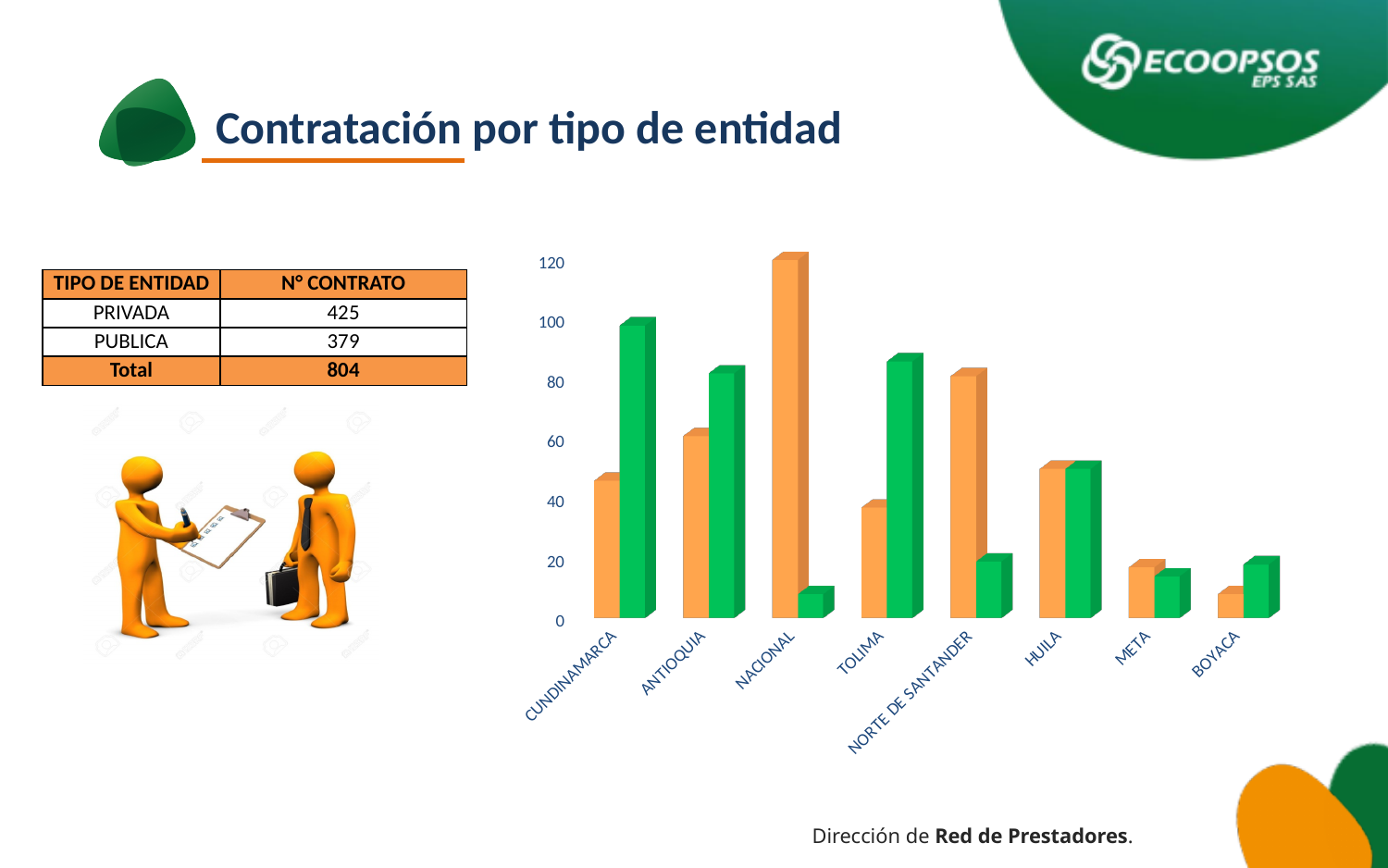
Which category has the shortest orange bar? BOYACA Which category has the tallest green bar? CUNDINAMARCA Is the green bar for NORTE DE SANTANDER greater or less than 40? less Which is taller, the orange bar for NORTE DE SANTANDER or the orange bar for TOLIMA? NORTE DE SANTANDER Which category has the tallest orange bar? NACIONAL Which category has the shortest green bar? NACIONAL For ANTIOQUIA, which bar is taller, the orange one or the green one? green What kind of chart is shown on the slide? bar chart How many categories are shown on the x axis of the chart? 8 Is the orange bar for NACIONAL greater or less than 100? greater Is the green bar for TOLIMA greater or less than 80? greater